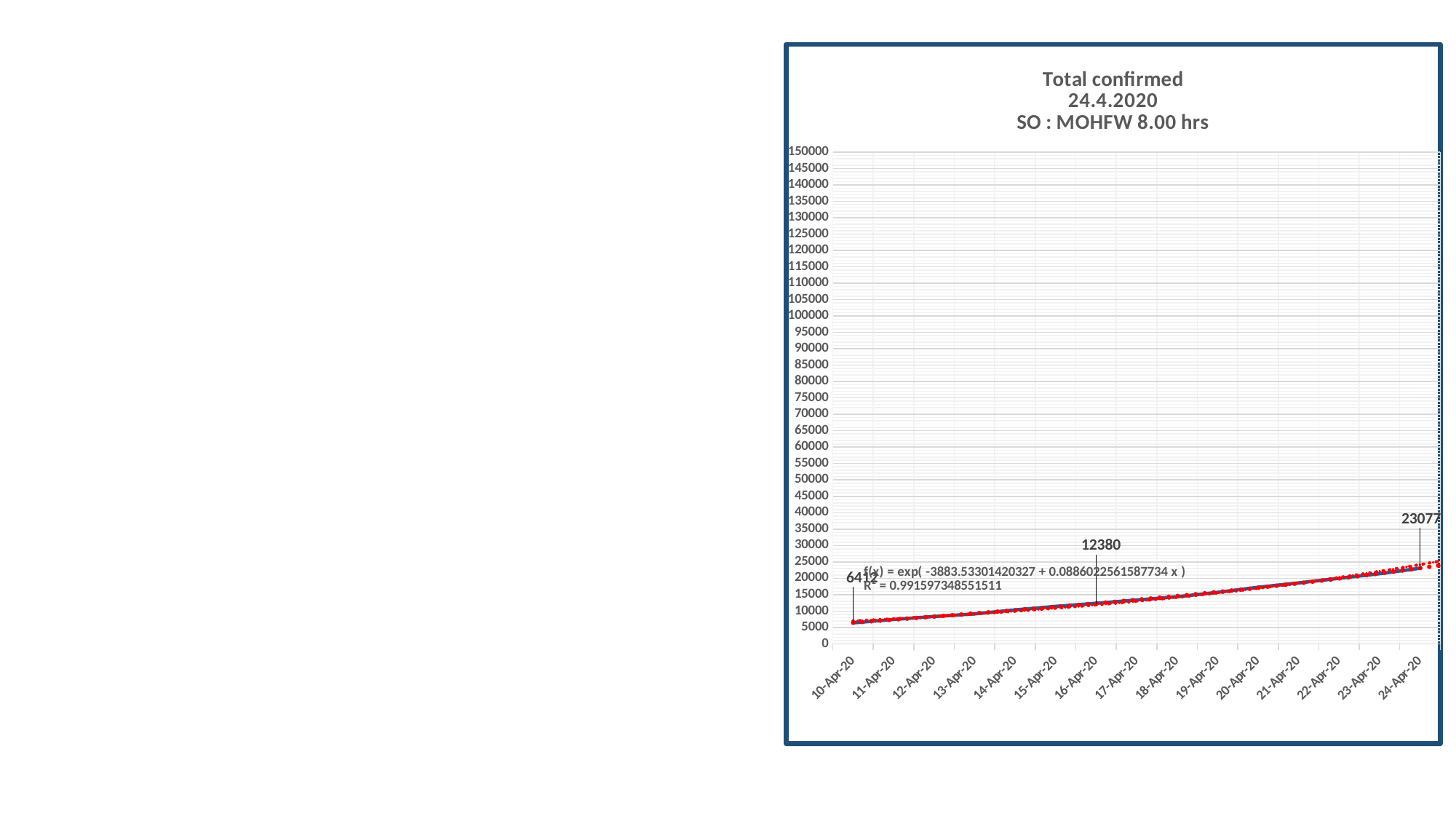
Which date has the higher total confirmed value, 10-Apr-20 or 24-Apr-20? 24-Apr-20 What is the total confirmed value labelled on 24-Apr-20? 23077 What is the total confirmed value labelled on 10-Apr-20? 6412 Do the total confirmed values rise or fall from 10-Apr-20 to 24-Apr-20? rise How many dates are labelled on the x axis? 15 Is the value for 22-Apr-20 greater or less than 15000? greater What R² value is shown for the fitted trendline? 0.991597348551511 Is the value for 20-Apr-20 greater or less than 25000? less What is the difference between the labelled values on 24-Apr-20 and 10-Apr-20? 16665 What is the total confirmed value labelled on 16-Apr-20? 12380 What is the difference between the labelled values on 16-Apr-20 and 10-Apr-20? 5968 What is the difference between the labelled values on 24-Apr-20 and 16-Apr-20? 10697